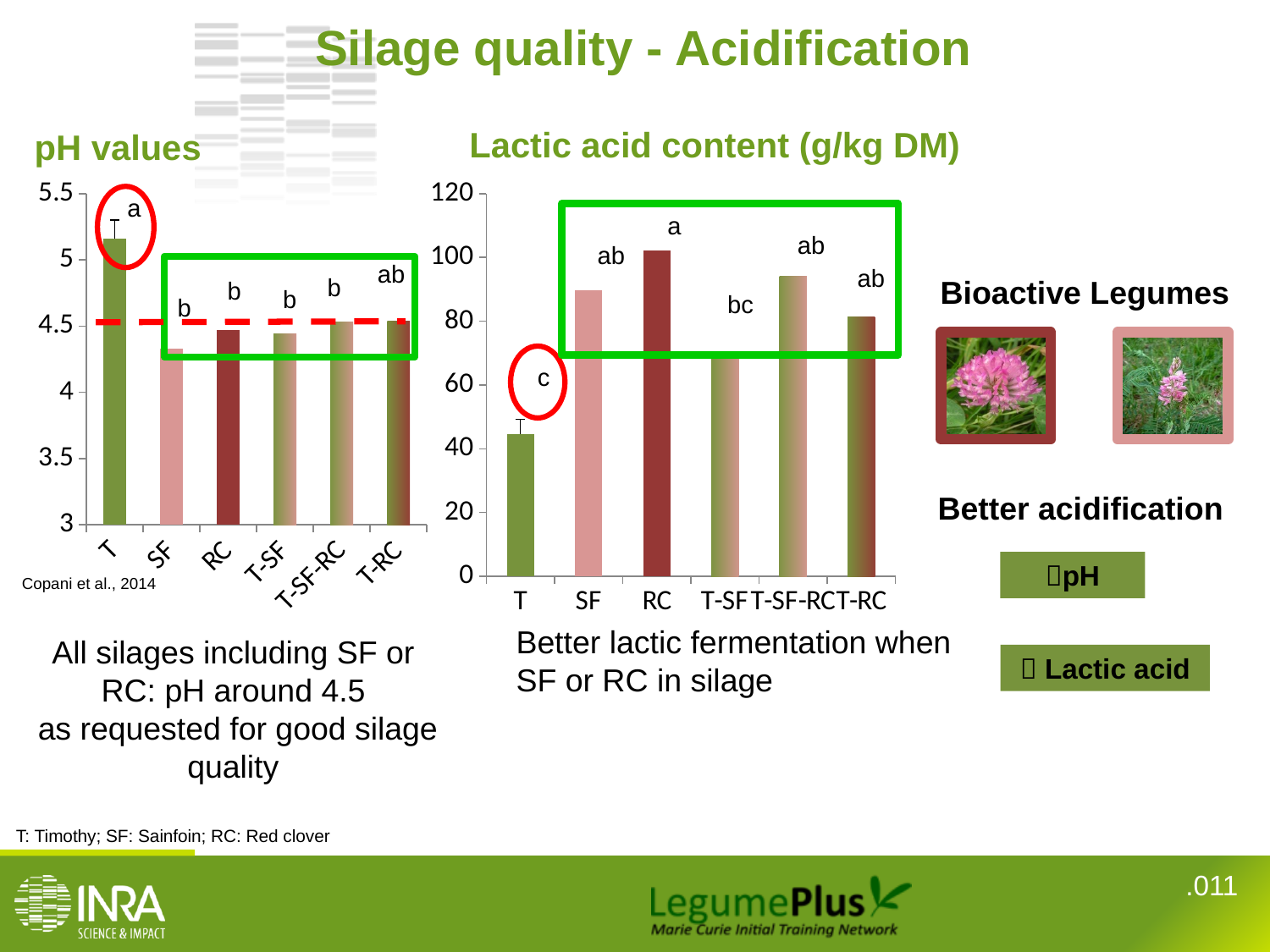
How many categories are shown on the x axis of the 'pH values' chart? 6 In the 'pH values' chart, which category has the lowest pH? SF In the 'Lactic acid content (g/kg DM)' chart, which category has the highest value? RC In the 'Lactic acid content (g/kg DM)' chart, is the value for T greater or less than 60? less In the 'Lactic acid content (g/kg DM)' chart, what letter is printed above the bar for T? c In the 'Lactic acid content (g/kg DM)' chart, which category has the lowest value? T In the 'pH values' chart, is the value for T greater or less than 5? greater In the 'Lactic acid content (g/kg DM)' chart, is the value for RC greater or less than 100? greater In the 'Lactic acid content (g/kg DM)' chart, which is larger, the value for SF or the value for T-SF? SF What kind of chart is the 'pH values' chart? bar chart In the 'pH values' chart, which category has the highest pH? T